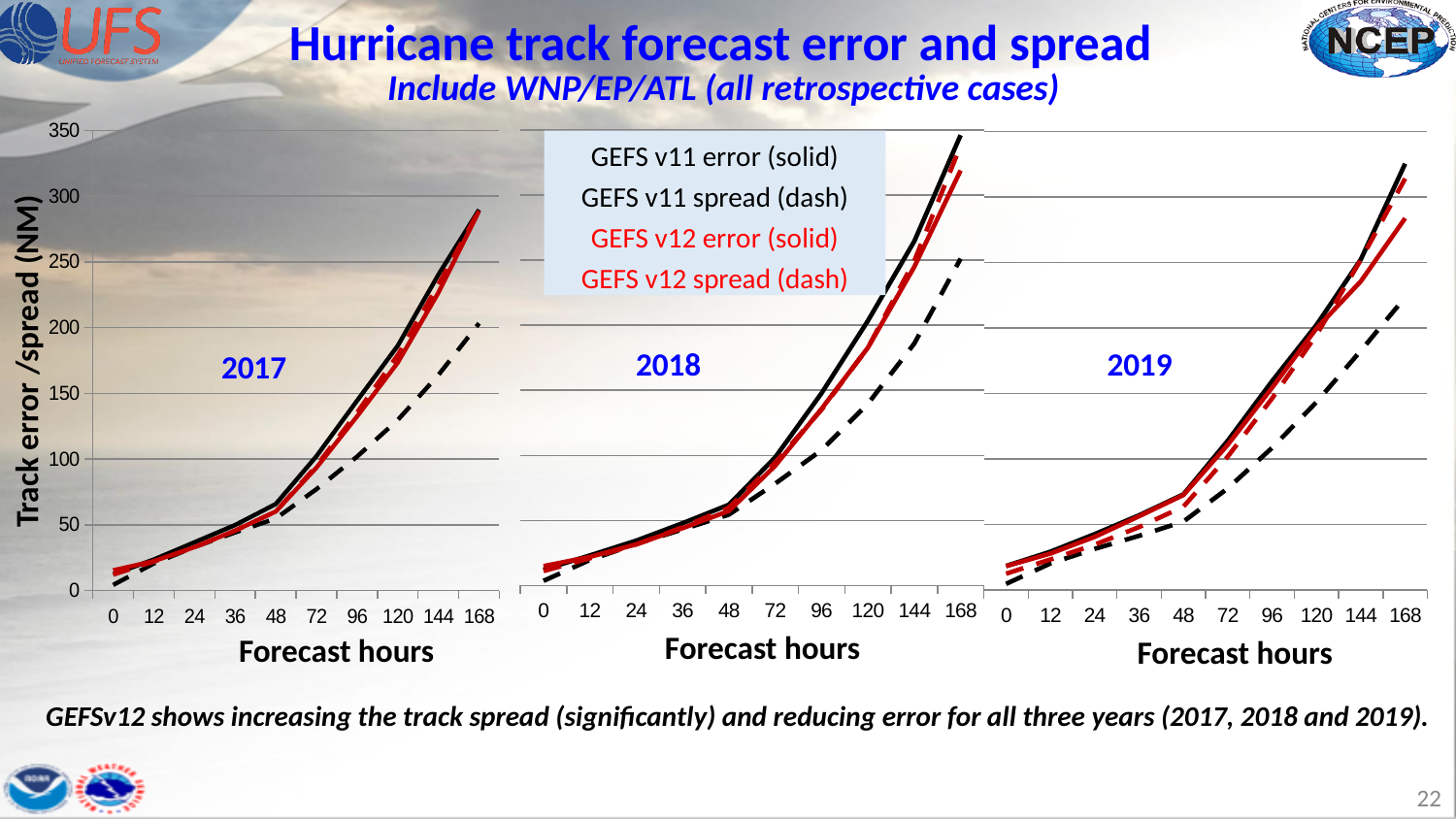
How many series does the legend list for the charts? 4 What kind of chart is used for the 2017, 2018 and 2019 panels on this slide? Line chart In the 2019 chart, which series has the lowest value at 168 hours? GEFS v11 spread (dash) In the 2017 chart, is the GEFS v11 error (solid black) at 168 hours greater or less than 250? greater In the 2019 chart, is the GEFS v12 error (solid red) at 168 hours greater or less than 300? less In the 2017 chart, which is larger at 168 hours: the GEFS v11 spread or the GEFS v12 spread? GEFS v12 spread In the 2017 chart, do the track error and spread values rise or fall as forecast hours increase? Rise In the 2017 chart, is the GEFS v11 error (solid black) at 120 hours greater or less than 150? greater In the 2018 chart, which is larger at 168 hours: the GEFS v11 error or the GEFS v12 error? GEFS v11 error What is the label of the y axis shared by the three charts? Track error /spread (NM) How many forecast-hour tick marks are shown on the x axis of the 2017 chart? 10